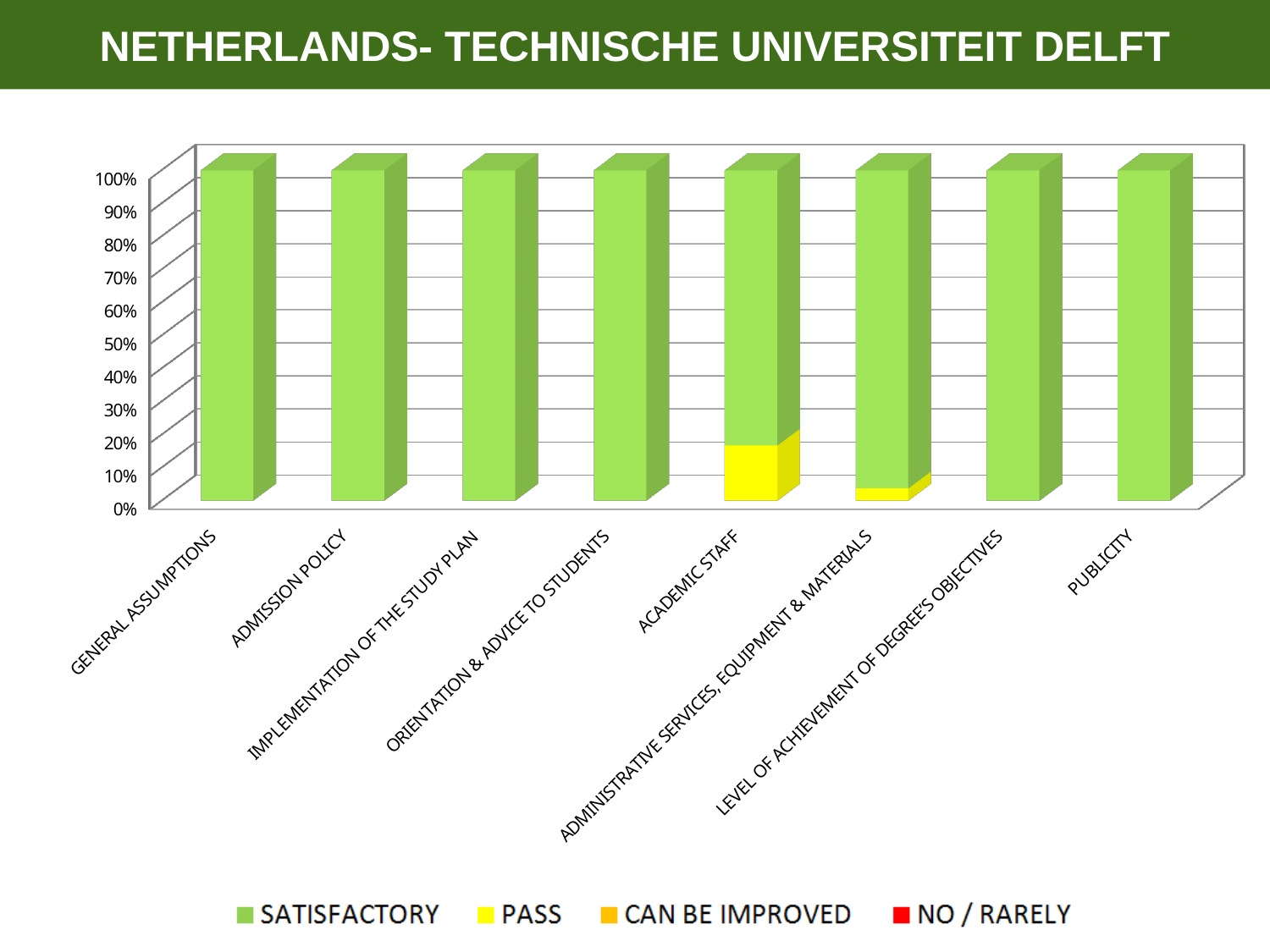
How many series does the chart's legend list? 4 How many categories are shown along the x axis of the chart? 8 Which legend entry is shown in yellow? PASS Is the PASS value for ACADEMIC STAFF greater or less than 30%? less Is the PASS value for ADMINISTRATIVE SERVICES, EQUIPMENT & MATERIALS greater or less than 10%? less Which category has the largest PASS segment? ACADEMIC STAFF How many categories show a visible PASS segment? 2 What is the total height of the stacked bar for PUBLICITY? 100% Is the SATISFACTORY value for ACADEMIC STAFF greater or less than 50%? greater What kind of chart is shown on the slide? Stacked bar chart Is the PASS segment for ACADEMIC STAFF larger or smaller than the PASS segment for ADMINISTRATIVE SERVICES, EQUIPMENT & MATERIALS? Larger What is the title of the slide containing the chart? NETHERLANDS- TECHNISCHE UNIVERSITEIT DELFT